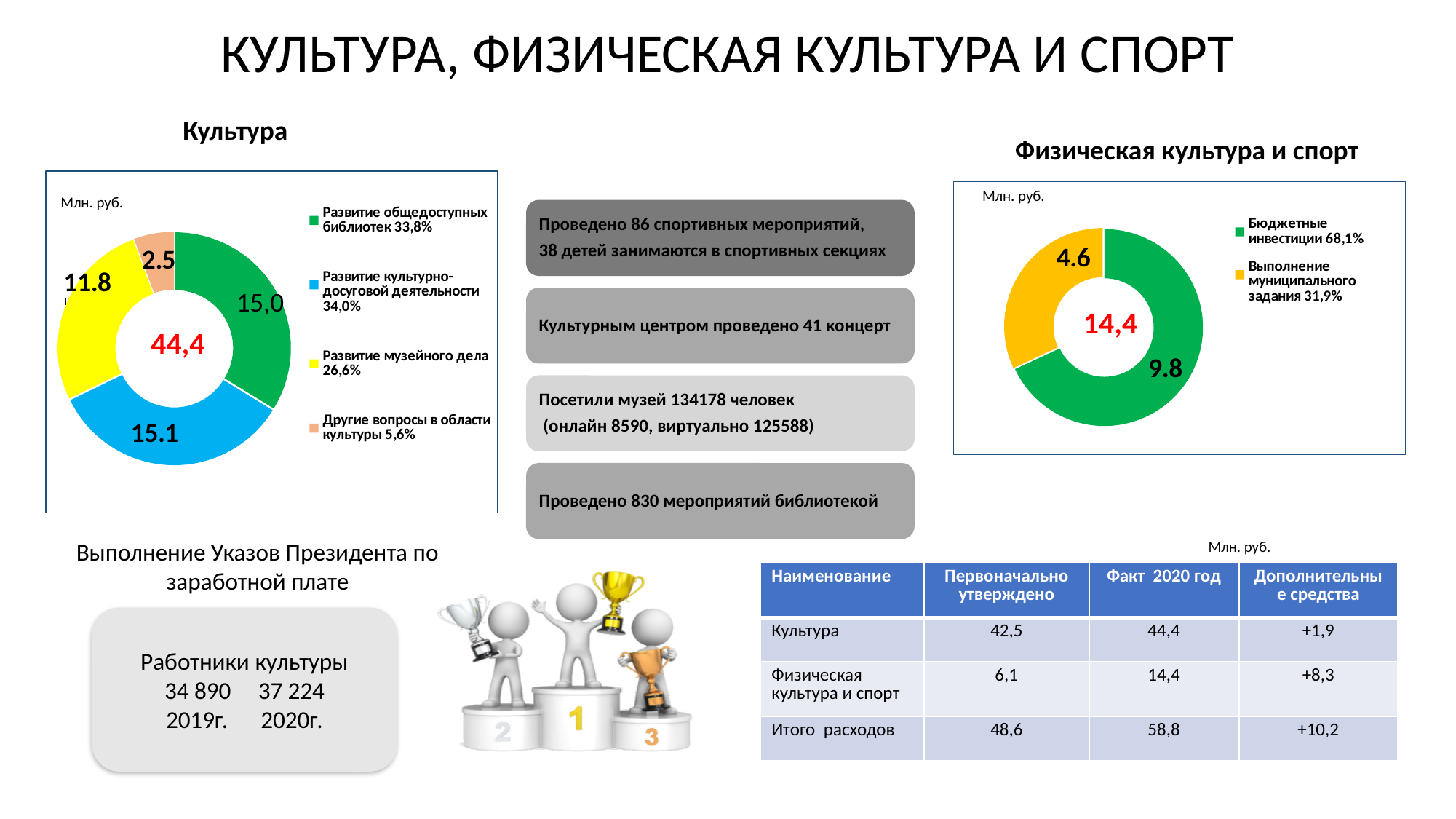
In the Физическая культура и спорт chart, what percentage share does the legend give for Выполнение муниципального задания? 31,9% In the Культура chart, what is the value for Развитие музейного дела? 11.8 What unit is indicated in the top-left corner of the Физическая культура и спорт chart? Млн. руб. In the Физическая культура и спорт chart, what is the value for Бюджетные инвестиции? 9.8 What total value is shown in the centre of the Культура chart? 44,4 In the Физическая культура и спорт chart, which category has the larger value, Бюджетные инвестиции or Выполнение муниципального задания? Бюджетные инвестиции In the Культура chart, which category has the smallest value? Другие вопросы в области культуры In the Культура chart, what percentage share is shown in the legend for Развитие общедоступных библиотек? 33,8% What kind of chart is the Физическая культура и спорт chart? Doughnut chart In the Культура chart, how many categories does the legend list? 4 In the Культура chart, what is the difference between the values for Развитие музейного дела and Другие вопросы в области культуры? 9.3 In the Культура chart, what is the value for Другие вопросы в области культуры? 2.5